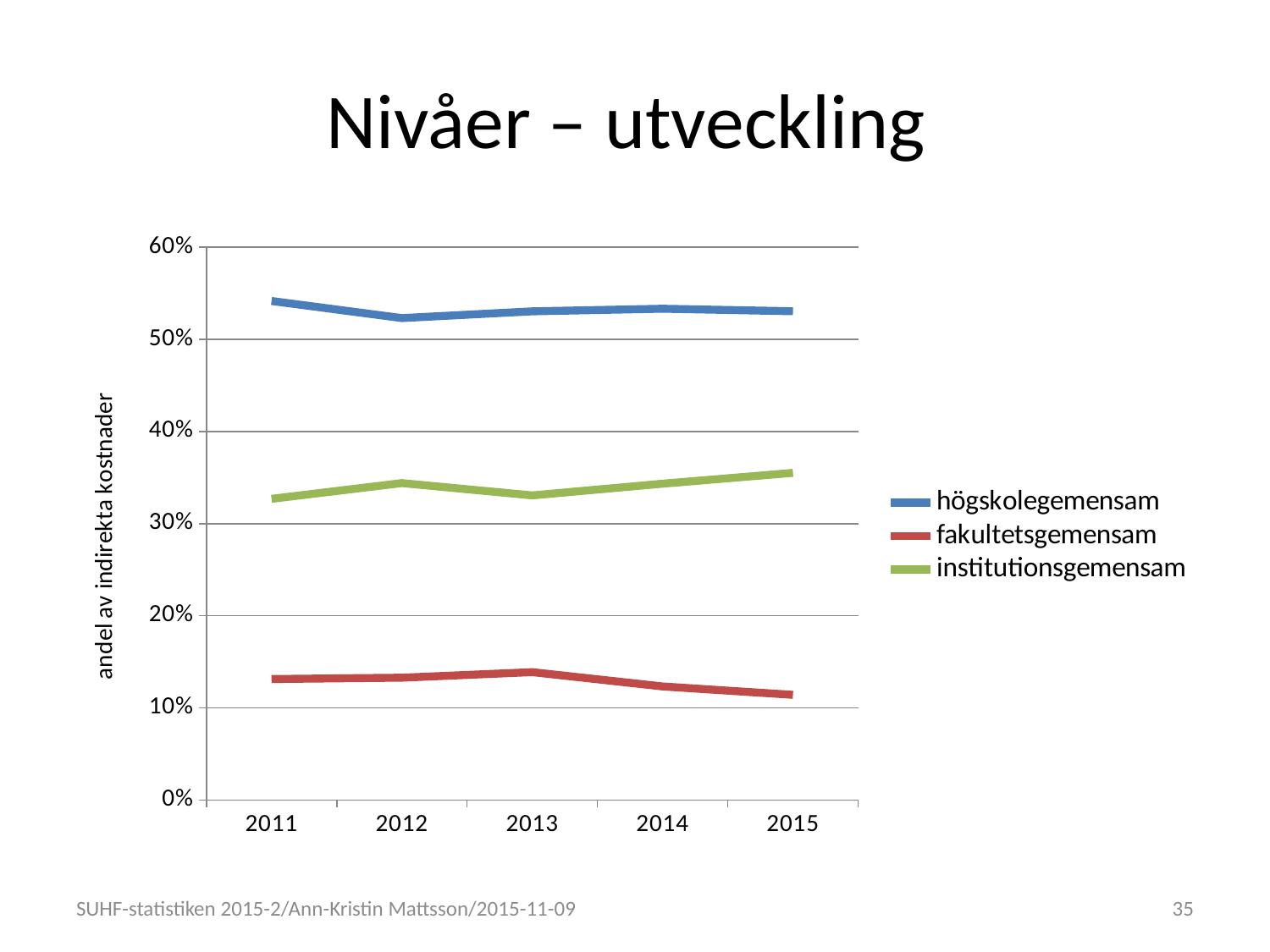
What is the label on the vertical axis? andel av indirekta kostnader How many years are shown on the x axis? 5 Is the value for högskolegemensam in 2011 greater or less than 50%? greater In 2013, which is larger: institutionsgemensam or fakultetsgemensam? institutionsgemensam What kind of chart is shown on the slide? line chart Is the value for fakultetsgemensam in 2015 greater or less than 10%? greater Does the fakultetsgemensam line rise or fall from 2013 to 2015? fall Which series has the lowest value in 2011? fakultetsgemensam Is the value for fakultetsgemensam in 2013 greater or less than 20%? less Which series has the highest value in 2015? högskolegemensam How many series does the legend list? 3